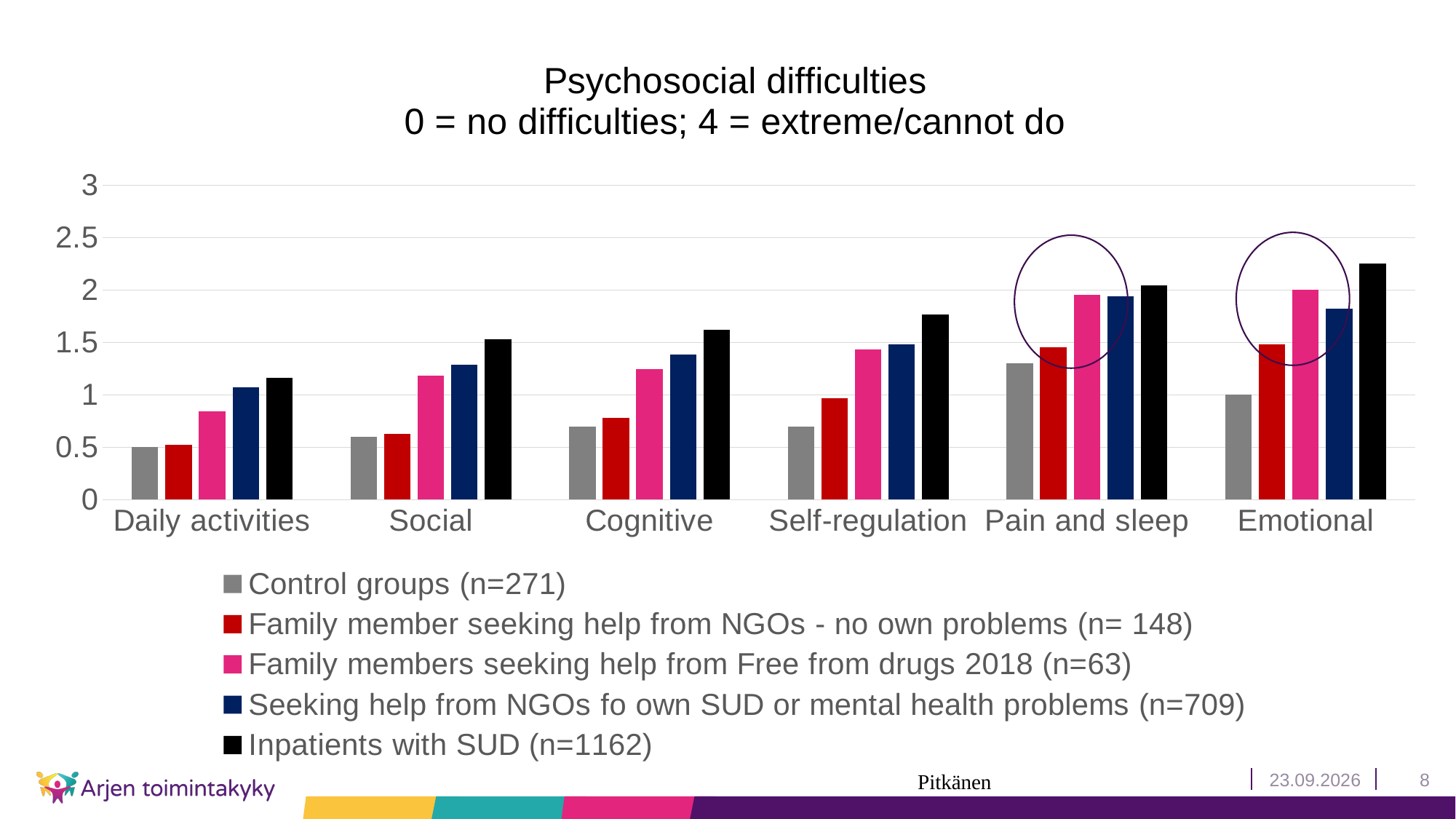
For Emotional, which is larger: Family members seeking help from Free from drugs 2018 (n=63) or Seeking help from NGOs fo own SUD or mental health problems (n=709)? Family members seeking help from Free from drugs 2018 (n=63) Is the Inpatients with SUD (n=1162) value for Emotional greater or less than 2? greater For Social, which is larger: Inpatients with SUD (n=1162) or Control groups (n=271)? Inpatients with SUD (n=1162) Is the Control groups (n=271) value for Pain and sleep greater or less than 1.5? less What kind of chart is shown on the slide? bar chart What is the first line of the chart title? Psychosocial difficulties For which category is the Control groups (n=271) value lowest? Daily activities Is the Family members seeking help from Free from drugs 2018 (n=63) value for Social greater or less than 1? greater Do the Inpatients with SUD (n=1162) values rise or fall from Daily activities to Emotional along the x axis? rise For which category is the Inpatients with SUD (n=1162) value highest? Emotional How many categories are shown on the x axis? 6 How many series does the legend list? 5